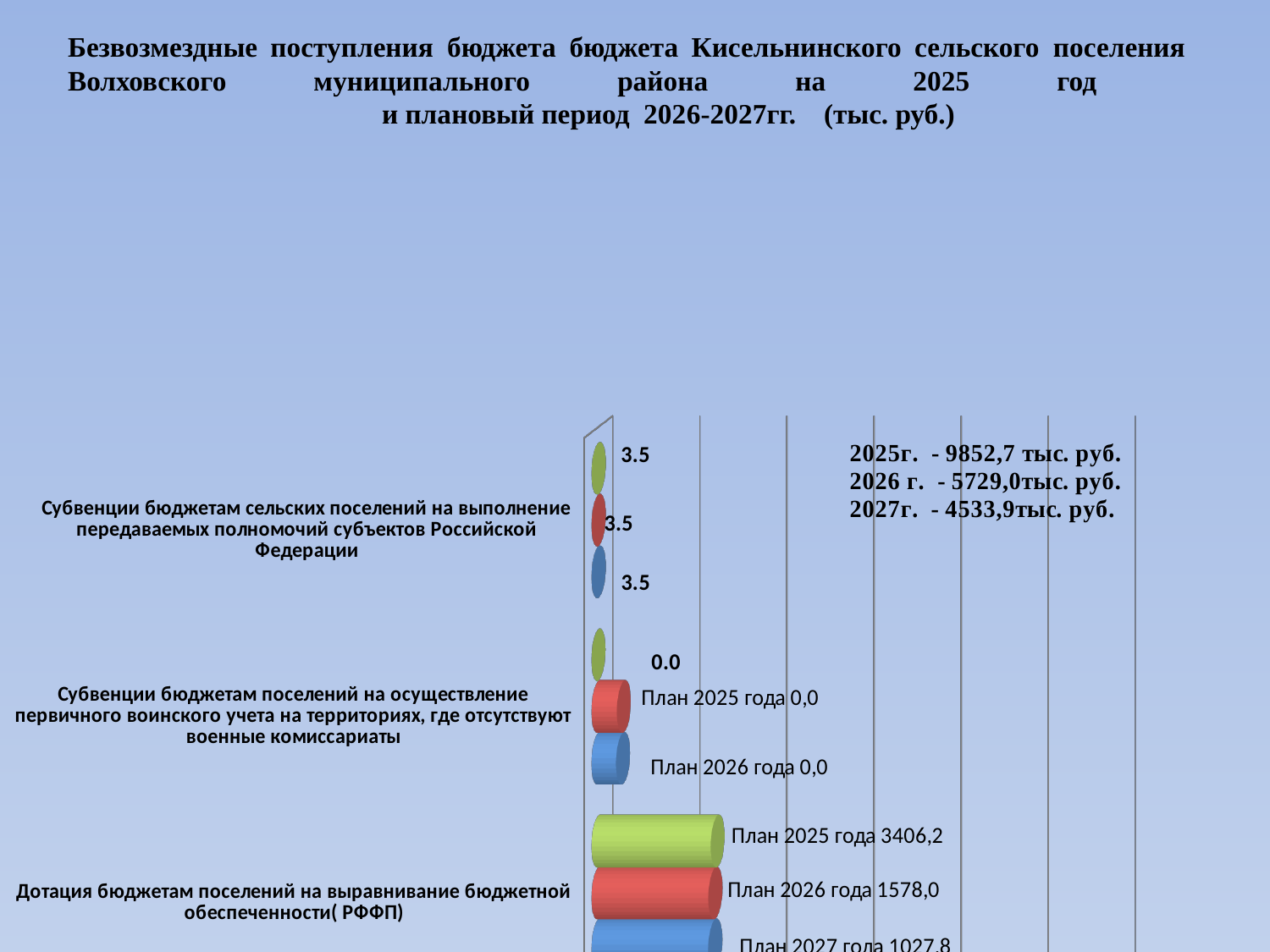
What kind of chart is shown on the slide? Bar chart What value is labelled on each bar for Субвенции бюджетам сельских поселений на выполнение передаваемых полномочий субъектов Российской Федерации? 3.5 For Дотация бюджетам поселений на выравнивание бюджетной обеспеченности( РФФП), which is larger: План 2025 года or План 2027 года? План 2025 года Do the values for Дотация бюджетам поселений на выравнивание бюджетной обеспеченности( РФФП) rise or fall from План 2025 года to План 2027 года? Fall What is the difference between План 2026 года and План 2027 года for Дотация бюджетам поселений на выравнивание бюджетной обеспеченности( РФФП)? 550,2 What is the value of План 2027 года for Дотация бюджетам поселений на выравнивание бюджетной обеспеченности( РФФП)? 1027,8 What is the difference between План 2025 года and План 2026 года for Дотация бюджетам поселений на выравнивание бюджетной обеспеченности( РФФП)? 1828,2 According to the text on the chart, what is the total for 2025г.? 9852,7 тыс. руб. What is the value of План 2025 года for Дотация бюджетам поселений на выравнивание бюджетной обеспеченности( РФФП)? 3406,2 What is the value of План 2026 года for Дотация бюджетам поселений на выравнивание бюджетной обеспеченности( РФФП)? 1578,0